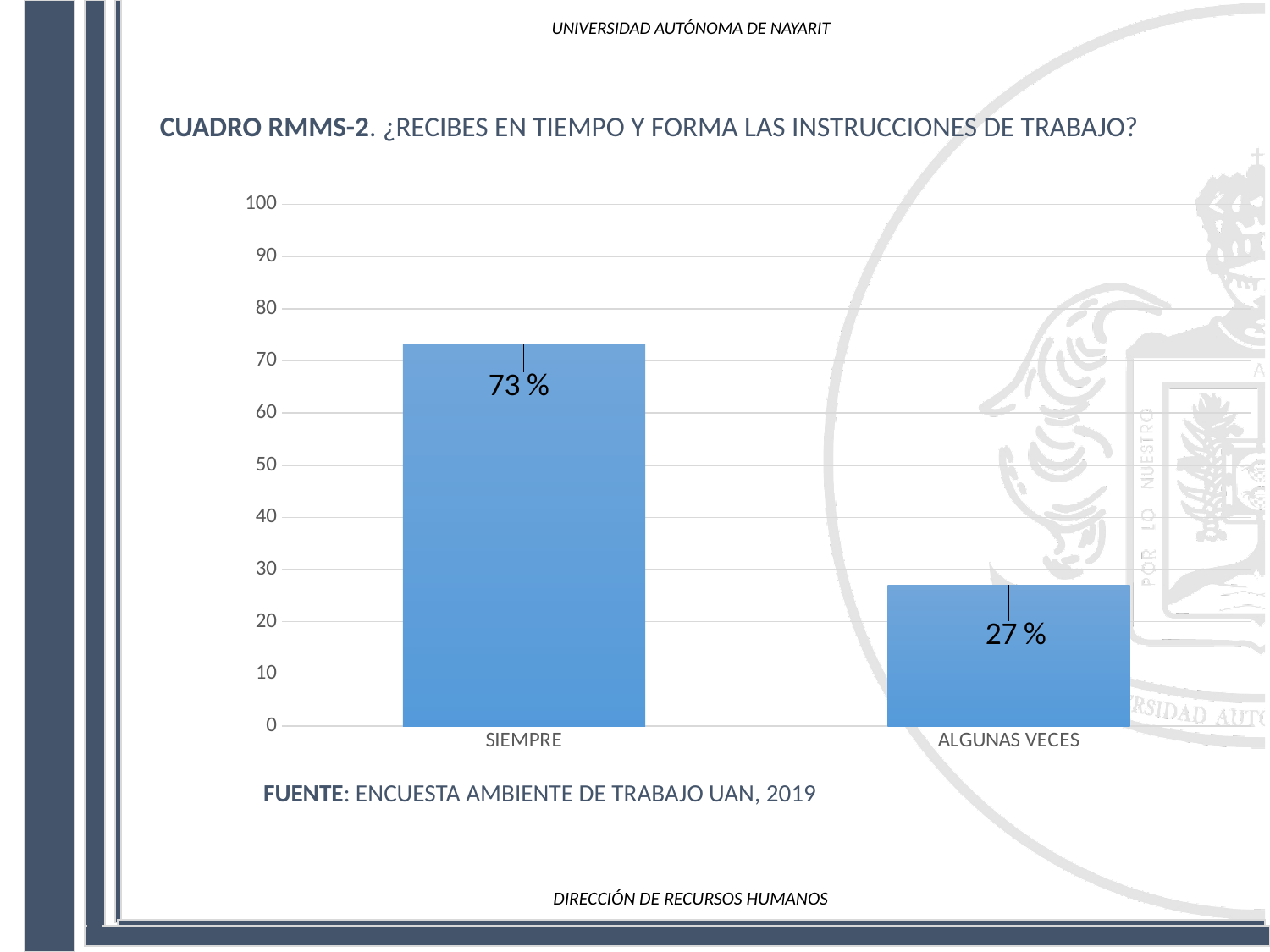
How many categories are shown on the chart? 2 What is the maximum value shown on the vertical axis? 100 Is the value for SIEMPRE greater or less than 70? greater Which category has the highest value? SIEMPRE What kind of chart is shown on the slide? bar chart What source is cited below the chart? ENCUESTA AMBIENTE DE TRABAJO UAN, 2019 Is the value for ALGUNAS VECES greater or less than 30? less What is the value for SIEMPRE? 73 % What is the value for ALGUNAS VECES? 27 % What is the difference between the values for SIEMPRE and ALGUNAS VECES? 46 % Which is larger, the value for SIEMPRE or the value for ALGUNAS VECES? SIEMPRE Which category has the lowest value? ALGUNAS VECES